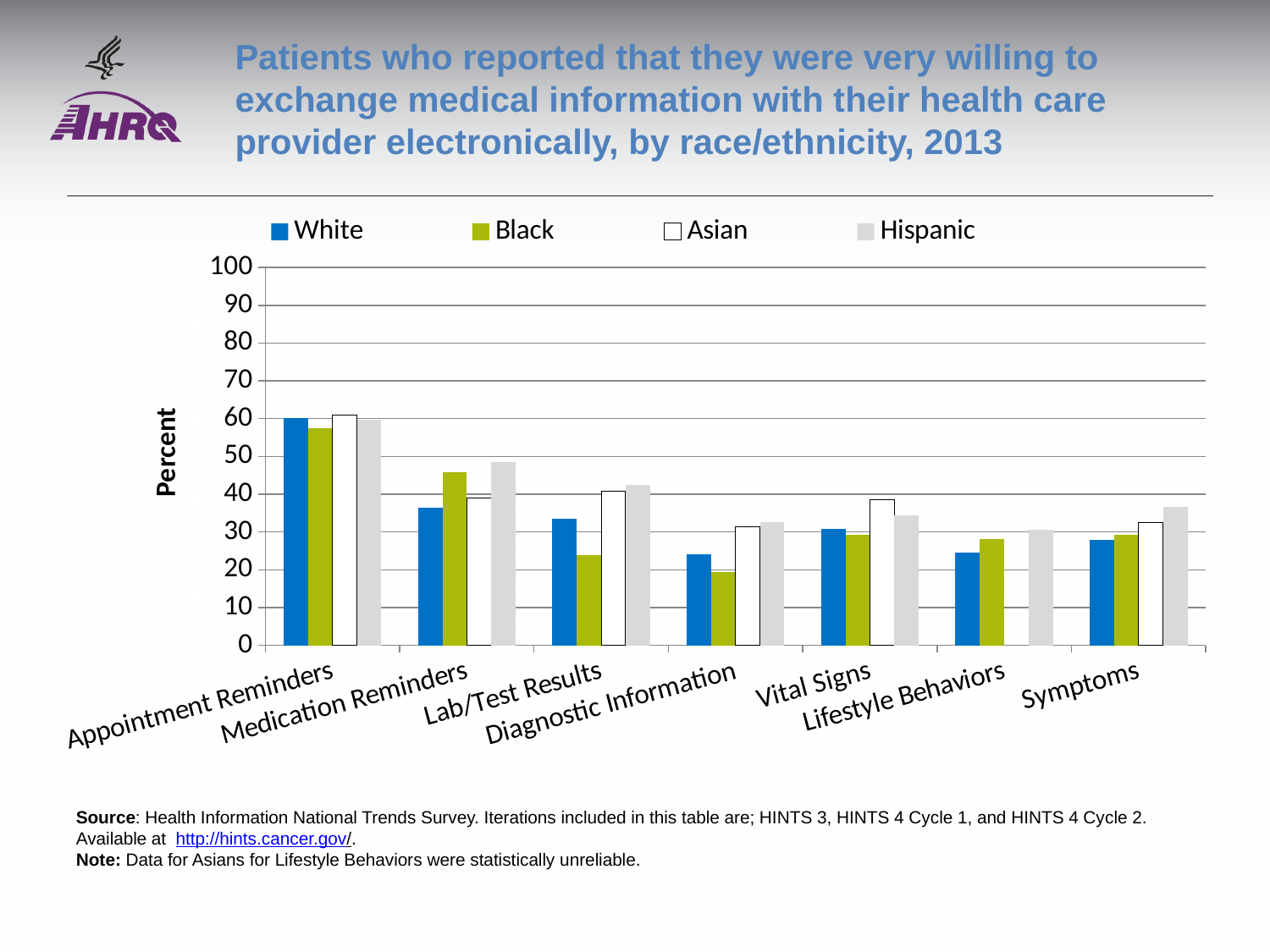
Which category has the lowest value for Black? Diagnostic Information Which series has no bar shown for Lifestyle Behaviors? Asian How many categories are shown along the x axis? 7 For Medication Reminders, which is larger: the value for White or the value for Black? Black For Lab/Test Results, which is larger: the value for Asian or the value for Black? Asian Is the value for White in Appointment Reminders greater or less than 50? greater Is the value for Hispanic in Medication Reminders greater or less than 40? greater What kind of chart is shown on the slide? bar chart Which category has the highest value for White? Appointment Reminders Is the value for Black in Diagnostic Information greater or less than 30? less What is the title of the y axis? Percent How many series does the legend list? 4